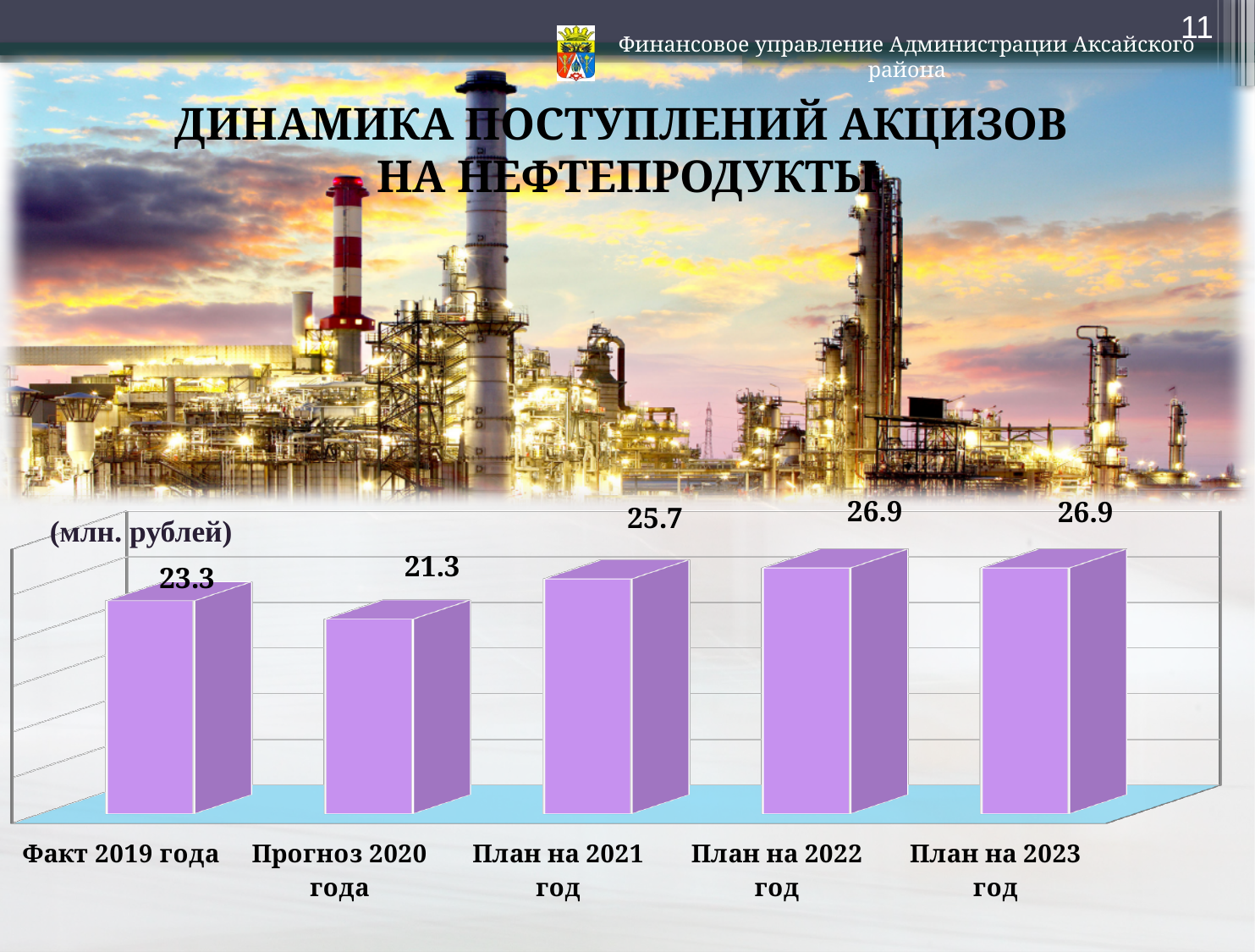
What kind of chart is shown on the slide? bar chart What is the value for Факт 2019 года? 23.3 What unit is indicated for the values in the chart? млн. рублей Do the values rise or fall from Прогноз 2020 года to План на 2022 год? rise Which is larger, the value for Факт 2019 года or the value for План на 2021 год? План на 2021 год What is the difference between the values for Факт 2019 года and Прогноз 2020 года? 2.0 What is the value for Прогноз 2020 года? 21.3 How many categories are shown in the chart? 5 What is the value for План на 2022 год? 26.9 Which category has the lowest value? Прогноз 2020 года What is the difference between the values for План на 2021 год and Прогноз 2020 года? 4.4 What is the value for План на 2021 год? 25.7